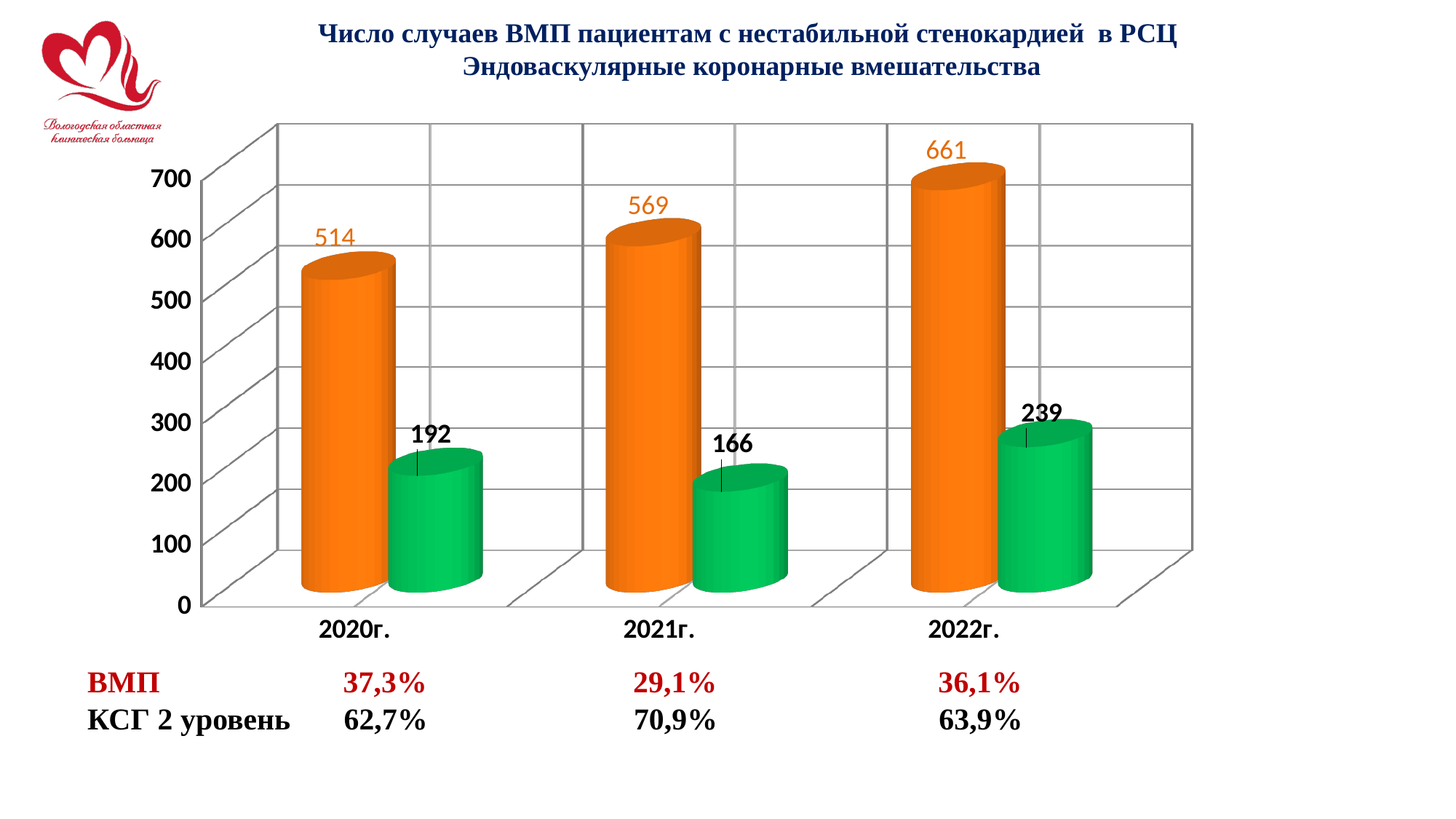
What is the difference between the orange and green bars for 2021г.? 403 What is the value of the orange bar for 2021г.? 569 What is the difference between the orange bar values for 2022г. and 2020г.? 147 Which is larger: the green bar for 2020г. or the green bar for 2021г.? 2020г. Do the orange bar values rise or fall from 2020г. to 2022г.? rise What is the second line of the chart title? Эндоваскулярные коронарные вмешательства In which year is the green bar lowest? 2021г. What kind of chart is shown on the slide? bar chart How many years are shown on the x axis? 3 What is the value of the green bar for 2022г.? 239 In which year is the orange bar highest? 2022г. What is the value of the green bar for 2020г.? 192